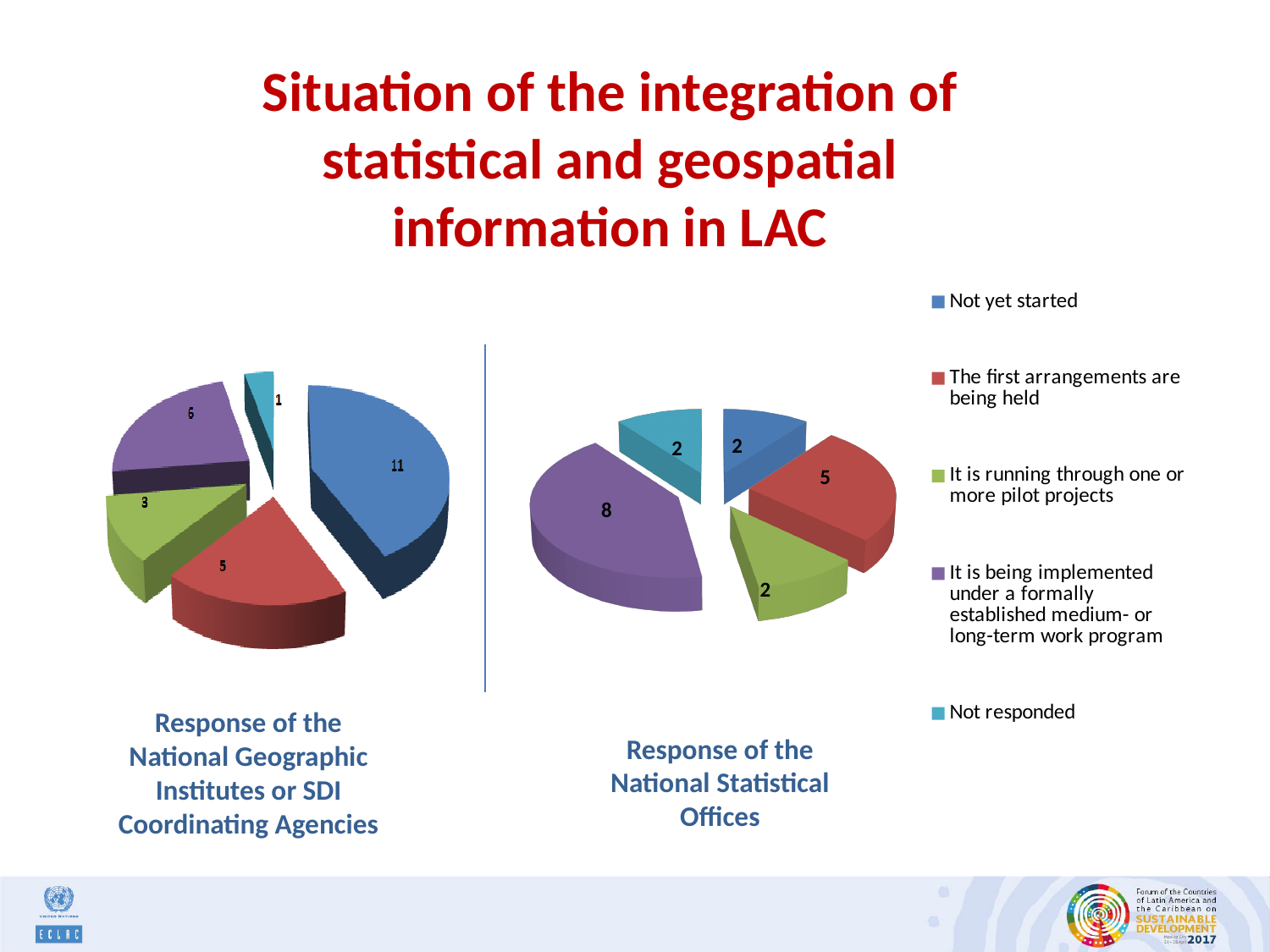
In the pie chart for the Response of the National Geographic Institutes or SDI Coordinating Agencies, what is the value for 'Not yet started'? 11 In the pie chart for the Response of the National Geographic Institutes or SDI Coordinating Agencies, what is the difference between 'Not yet started' and 'The first arrangements are being held'? 6 In the pie chart for the Response of the National Geographic Institutes or SDI Coordinating Agencies, which category has the largest slice? Not yet started In the pie chart for the Response of the National Statistical Offices, which category has the largest slice? It is being implemented under a formally established medium- or long-term work program In the pie chart for the Response of the National Geographic Institutes or SDI Coordinating Agencies, which is larger: 'It is being implemented under a formally established medium- or long-term work program' or 'It is running through one or more pilot projects'? It is being implemented under a formally established medium- or long-term work program What kind of chart is used for the Response of the National Statistical Offices? Pie chart Which colour represents 'Not responded' in the legend? Light blue In the pie chart for the Response of the National Statistical Offices, what is the total of all slices? 19 In the pie chart for the Response of the National Statistical Offices, what is the value for 'It is being implemented under a formally established medium- or long-term work program'? 8 In the pie chart for the Response of the National Geographic Institutes or SDI Coordinating Agencies, which category has the smallest slice? Not responded In the pie chart for the Response of the National Statistical Offices, what is the difference between 'It is being implemented under a formally established medium- or long-term work program' and 'The first arrangements are being held'? 3 How many categories does the legend list for the pie charts? 5